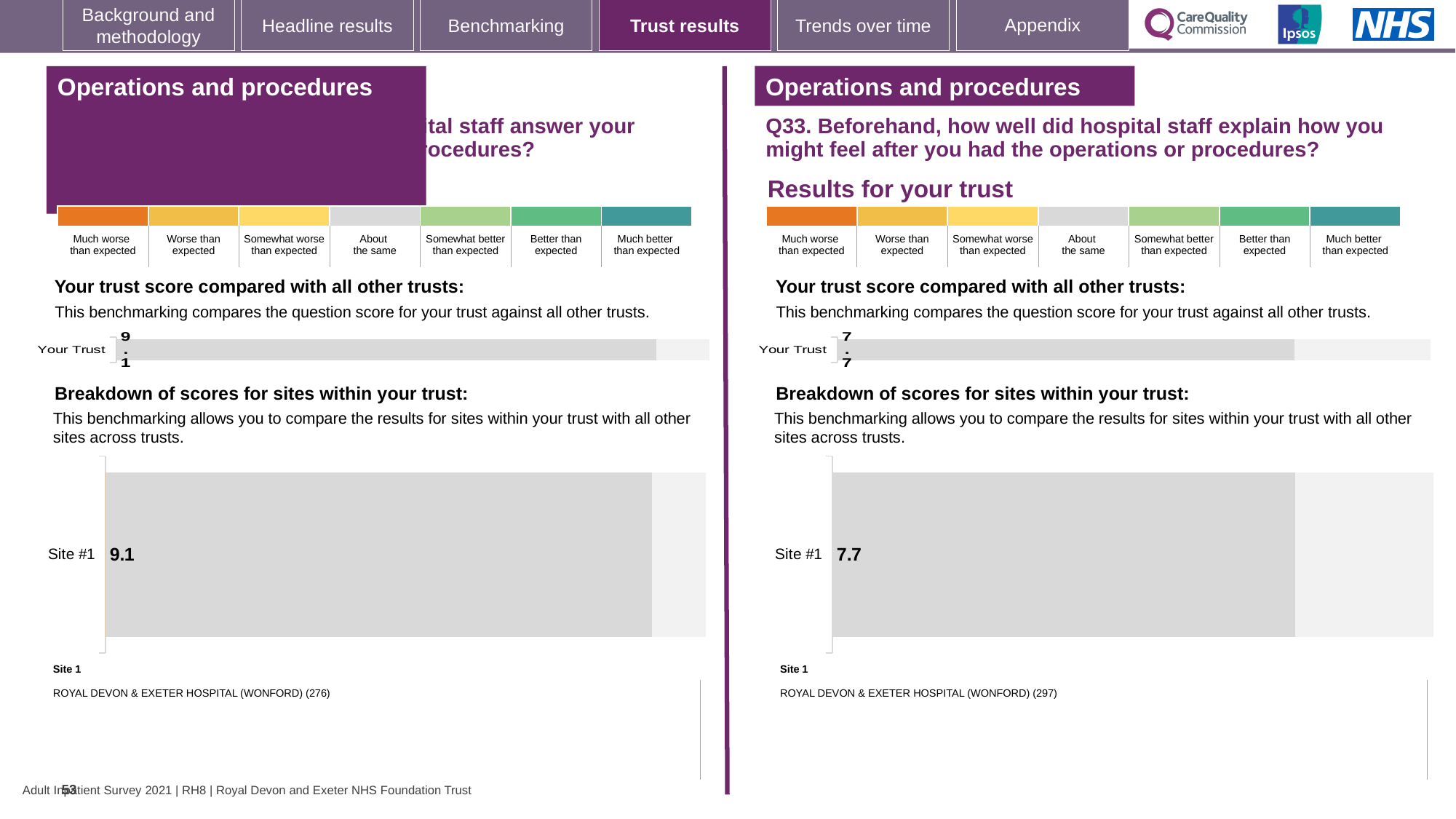
On the right-hand panel (Q33), what is the score shown for Your Trust in the 'Your trust score compared with all other trusts' chart? 7.7 On the left-hand panel, what is the score shown for Your Trust in the 'Your trust score compared with all other trusts' chart? 9.1 On the right-hand panel (Q33), which hospital is listed as Site 1 below the breakdown chart? ROYAL DEVON & EXETER HOSPITAL (WONFORD) On the left-hand panel, what score is shown for Site #1 in the 'Breakdown of scores for sites within your trust' chart? 9.1 How many sites are shown in the 'Breakdown of scores for sites within your trust' chart on the right-hand panel (Q33)? 1 What is the difference between the Site #1 score on the left-hand panel and the Site #1 score on the right-hand panel (Q33)? 1.4 On the right-hand panel (Q33), is the Site #1 score greater or less than 5? greater How many bars are plotted in the 'Your trust score compared with all other trusts' chart on the left-hand panel? 1 What kind of chart is used to show the Site #1 score on the right-hand panel (Q33)? Bar chart On the right-hand panel (Q33), what score is shown for Site #1 in the 'Breakdown of scores for sites within your trust' chart? 7.7 Which panel shows the higher Your Trust score, the left-hand panel or the right-hand panel (Q33)? Left-hand panel